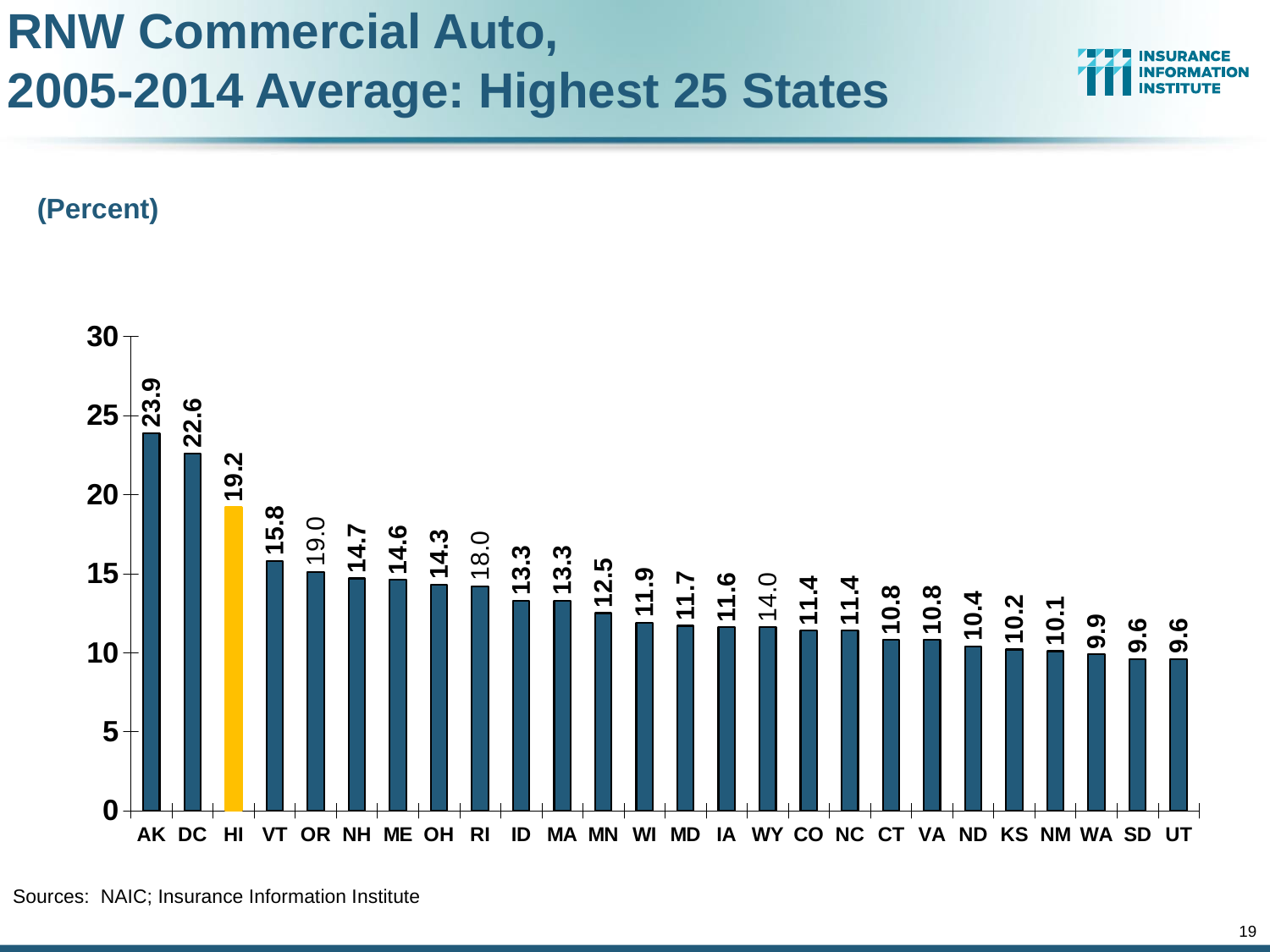
Which state has the highest value? AK What is the value for MN? 12.5 Which state's bar is highlighted in a different colour (yellow)? HI What is the value for ND? 10.4 What is the value for AK? 23.9 Do the values generally rise or fall from left to right along the x axis? Fall What is the value for HI? 19.2 Which is larger, the value for VT or the value for NH? VT What kind of chart is this? Bar chart What is the difference between the values for AK and DC? 1.3 Is the value for DC greater or less than 20? greater